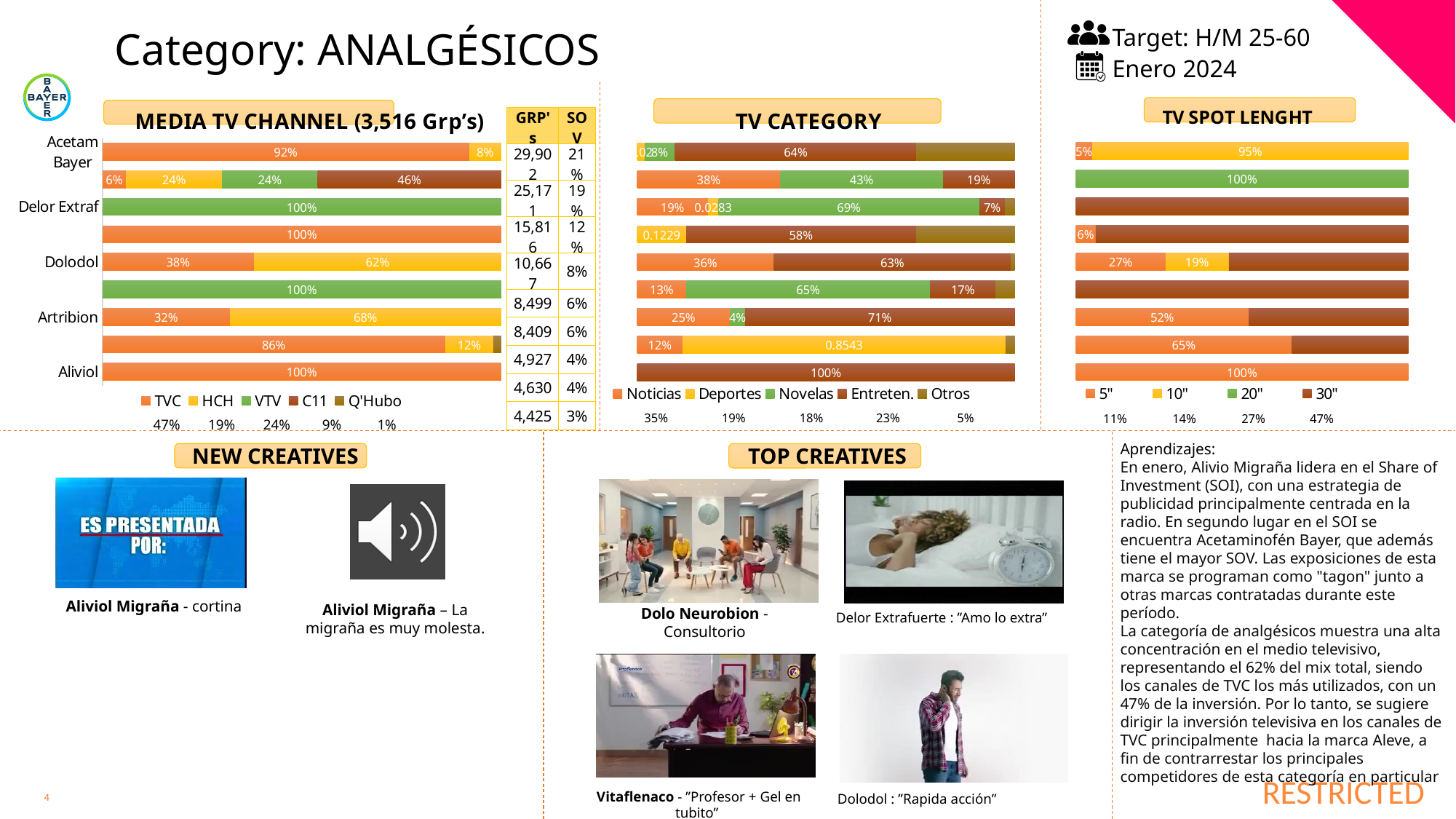
In the MEDIA TV CHANNEL chart, what is the difference between the HCH share and the TVC share for Dolodol? 24 percentage points In the TV SPOT LENGHT chart, what is the 10" share in the top bar? 95% In the TV CATEGORY chart, what overall percentage is shown under the Noticias legend entry? 35% In the MEDIA TV CHANNEL chart, what is the HCH share for Dolodol? 62% According to the title of the MEDIA TV CHANNEL chart, how many Grp's are there in total? 3,516 What kind of chart is the MEDIA TV CHANNEL chart? Stacked bar chart How many series does the legend of the TV CATEGORY chart list? 5 In the MEDIA TV CHANNEL chart, which is larger for Artribion, the TVC share or the HCH share? HCH In the MEDIA TV CHANNEL chart, what is the TVC share for Acetam Bayer? 92% How many series does the legend of the MEDIA TV CHANNEL chart list? 5 How many bars are plotted in the TV SPOT LENGHT chart? 9 In the MEDIA TV CHANNEL chart, what is the TVC share for Aliviol? 100%